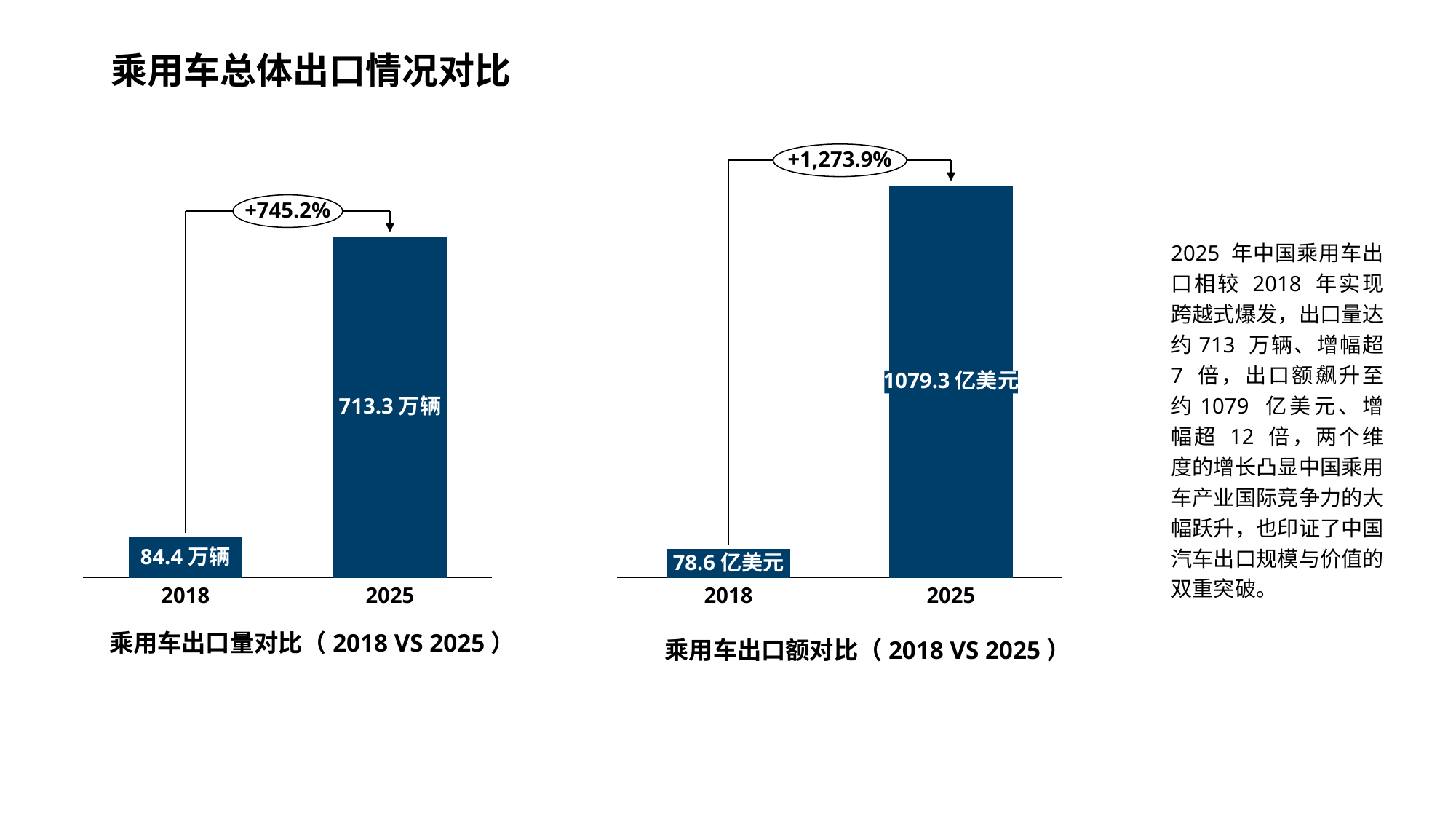
In the chart titled 乘用车出口额对比（2018 VS 2025）, which year has the lower value? 2018 In the chart titled 乘用车出口额对比（2018 VS 2025）, what is the value for 2025? 1079.3 亿美元 In the chart titled 乘用车出口额对比（2018 VS 2025）, what is the value for 2018? 78.6 亿美元 In the chart titled 乘用车出口额对比（2018 VS 2025）, what is the difference between the 2025 and 2018 values? 1000.7 亿美元 In the chart titled 乘用车出口量对比（2018 VS 2025）, what is the difference between the 2025 and 2018 values? 628.9 万辆 In the chart titled 乘用车出口量对比（2018 VS 2025）, what is the value for 2025? 713.3 万辆 In the left chart (乘用车出口量对比), what percentage change is shown between 2018 and 2025? +745.2% In the chart titled 乘用车出口量对比（2018 VS 2025）, what is the value for 2018? 84.4 万辆 In the chart titled 乘用车出口量对比（2018 VS 2025）, which year has the higher value? 2025 What type of chart is the left chart titled 乘用车出口量对比（2018 VS 2025）? Bar chart In the right chart (乘用车出口额对比), what percentage change is shown between 2018 and 2025? +1,273.9% How many bars are plotted in the chart titled 乘用车出口额对比（2018 VS 2025）? 2